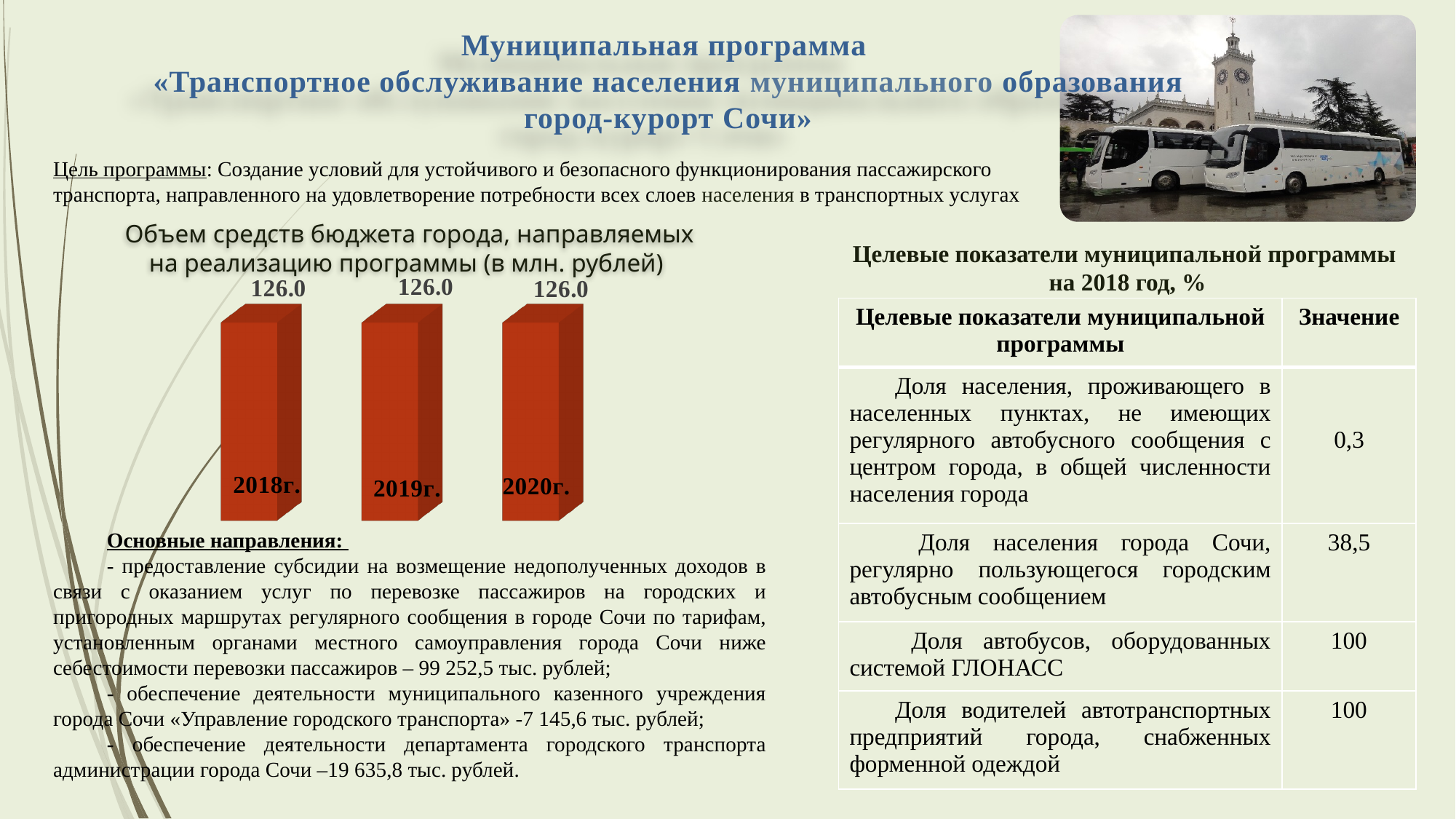
Do the values rise, fall, or stay the same from 2018г. to 2020г.? Stay the same Which years are shown as categories in the chart? 2018г., 2019г., 2020г. What kind of chart is shown on the slide? Bar chart What is the value for 2018г. in the chart? 126.0 How many bars (categories) are shown in the chart? 3 Is the value for 2019г. larger than, smaller than, or equal to the value for 2018г.? Equal What is the title of the chart? Объем средств бюджета города, направляемых на реализацию программы (в млн. рублей) What is the value for 2020г. in the chart? 126.0 In what units are the chart values given, according to the chart title? млн. рублей What is the value for 2019г. in the chart? 126.0 What is the difference between the values for 2018г. and 2020г.? 0.0